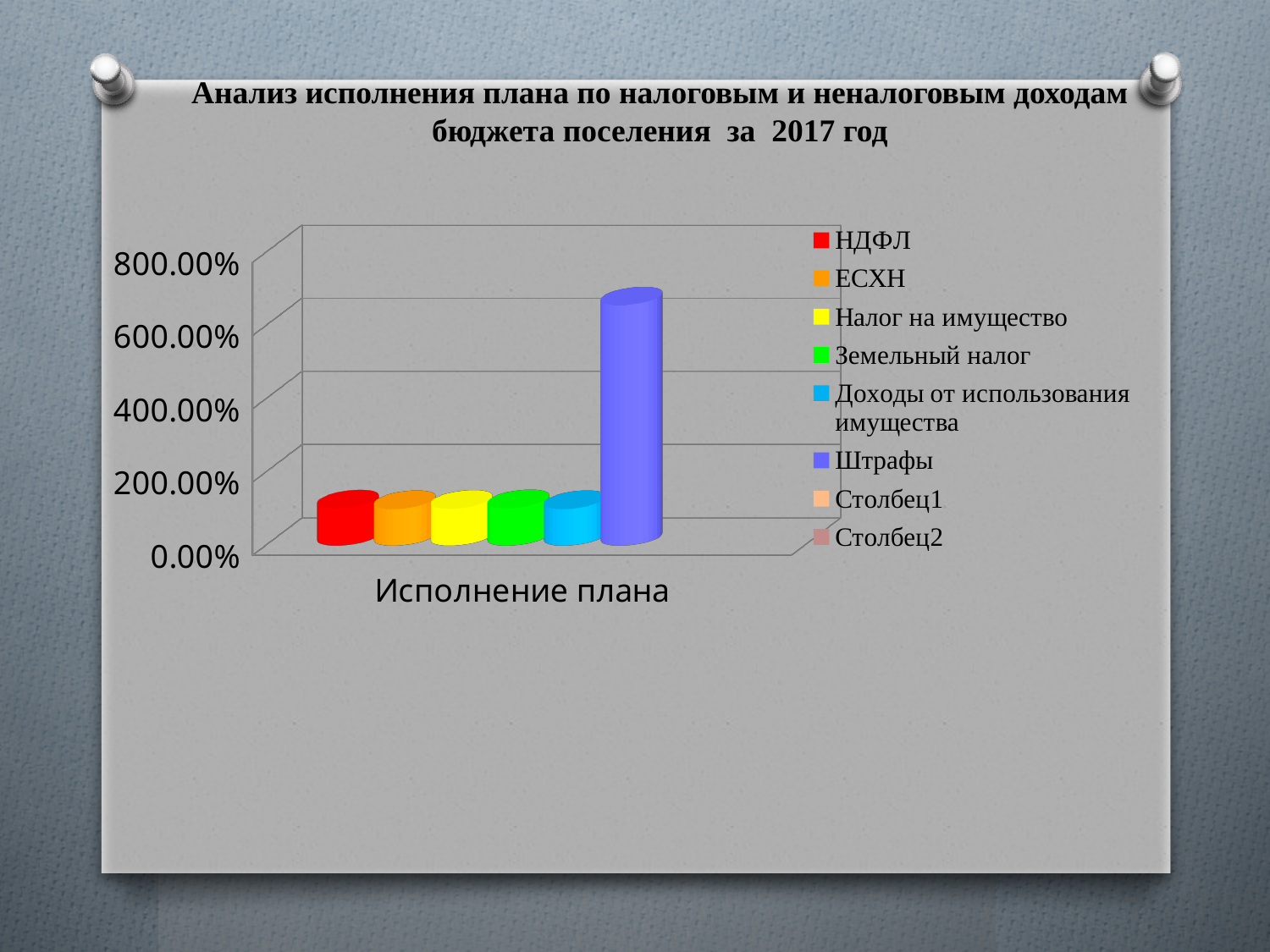
Is the value for Штрафы greater or less than 800.00%? less Which series has the highest value in the chart? Штрафы How many categories are shown on the x axis of the chart? 1 Which is larger, the value for Штрафы or the value for ЕСХН? Штрафы Is the value for Земельный налог greater or less than 400.00%? less What colour represents НДФЛ in the chart? red Is the value for Штрафы greater or less than 600.00%? greater How many series does the legend list? 8 What kind of chart is shown on the slide? bar chart What is the label of the category on the x axis? Исполнение плана